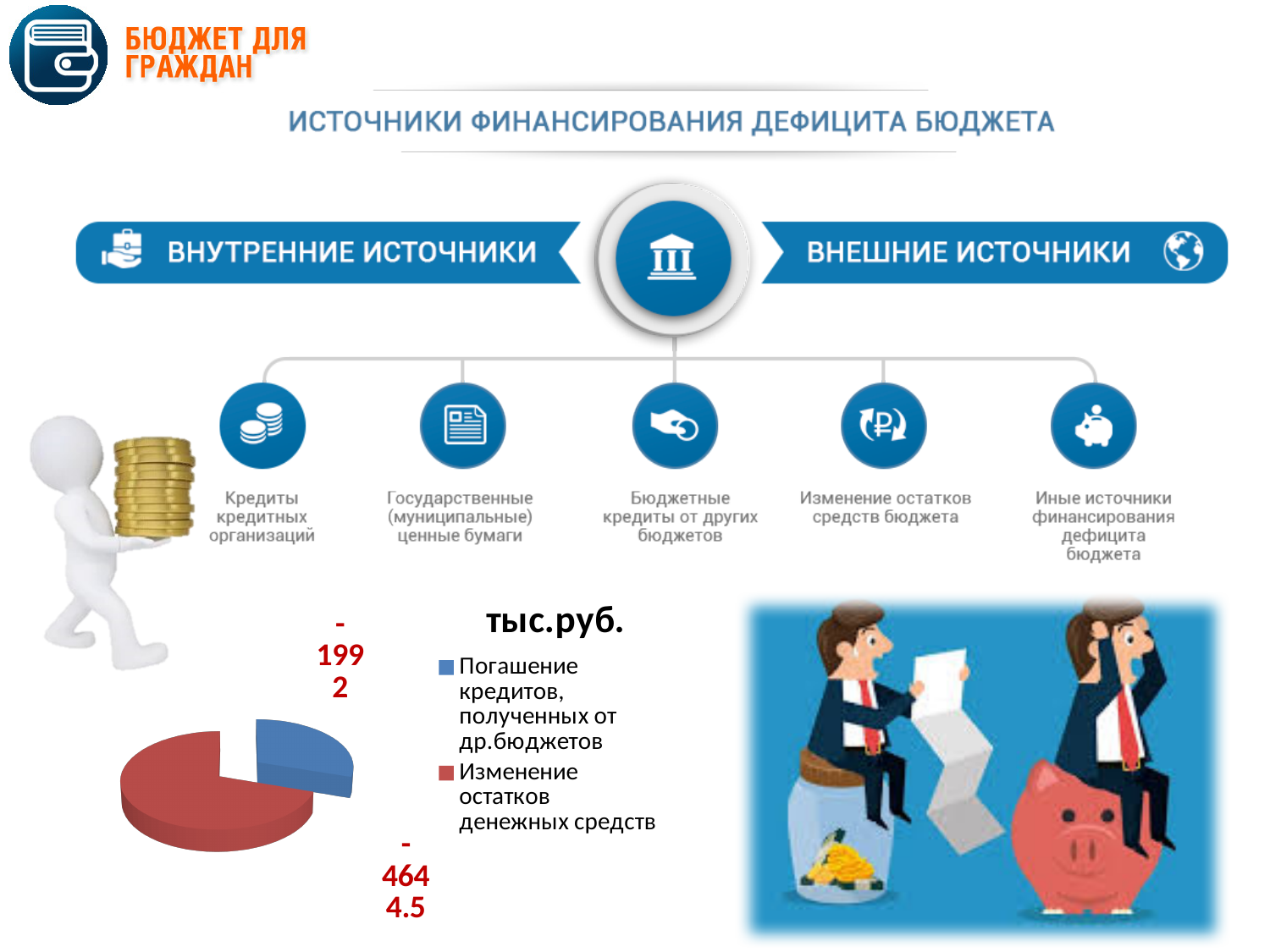
Which slice takes up a larger part of the pie chart: "Погашение кредитов, полученных от др.бюджетов" or "Изменение остатков денежных средств"? Изменение остатков денежных средств What value is shown for the slice "Изменение остатков денежных средств" in the pie chart? -4644.5 What kind of chart is shown at the bottom left of the slide? pie chart Which slice of the pie chart is the largest? Изменение остатков денежных средств Which slice of the pie chart is the smallest? Погашение кредитов, полученных от др.бюджетов What is the title of the pie chart? тыс.руб. What value is shown for the slice "Погашение кредитов, полученных от др.бюджетов" in the pie chart? -1992 What colour is the slice for "Изменение остатков денежных средств" in the pie chart? red What is the difference between the values -1992 and -4644.5 shown on the pie chart? 2652.5 How many slices does the pie chart have? 2 How many entries does the legend of the pie chart list? 2